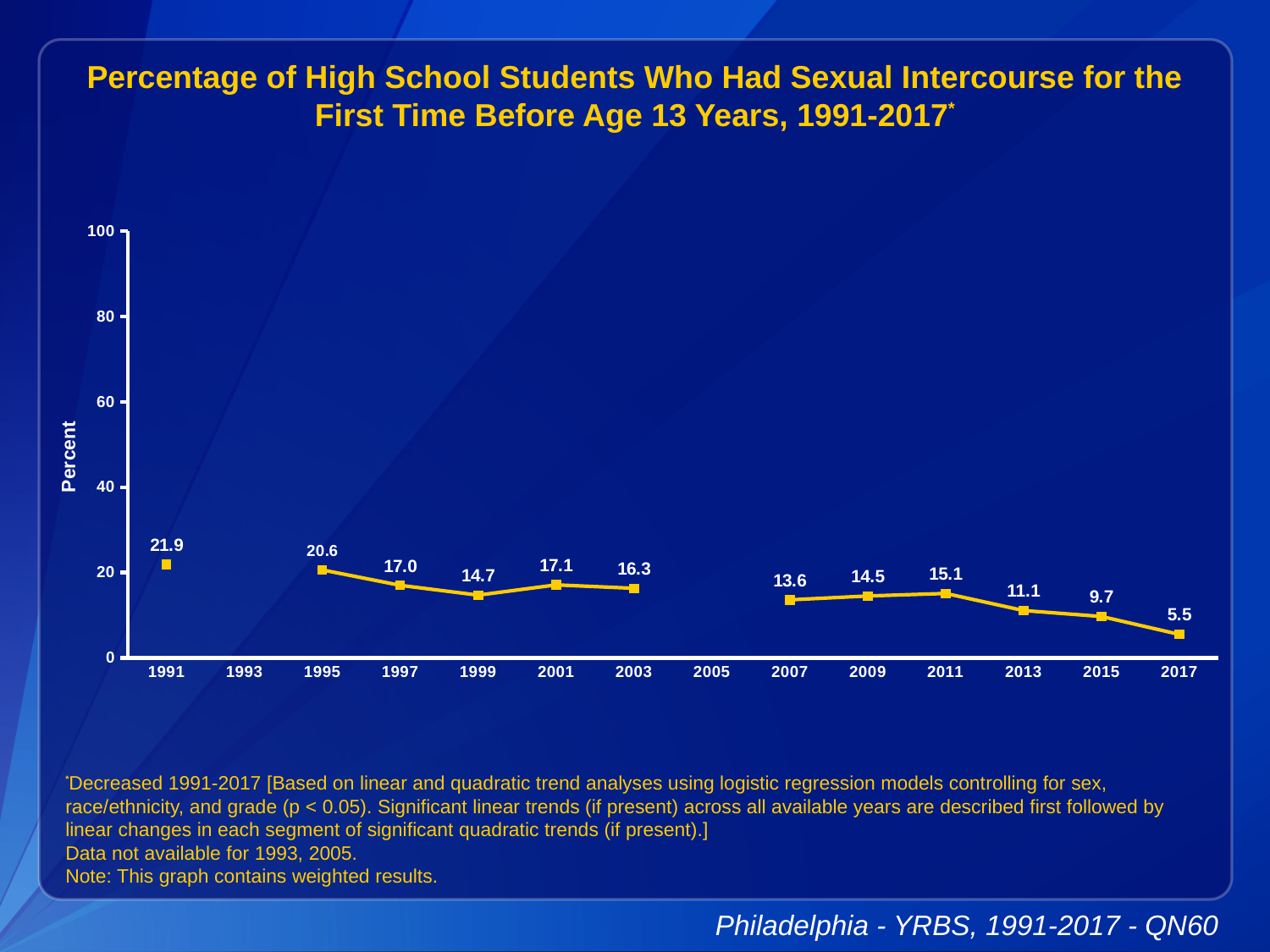
What is the value for 1991? 21.9 What kind of chart is shown on the slide? line chart How many years have data points plotted on the chart? 12 What is the value for 2017? 5.5 What is the value for 2009? 14.5 Do the values generally rise or fall from 1991 to 2017? fall Which is larger, the value for 2003 or the value for 2007? 2003 Is the value for 1995 greater or less than 20? greater Which year has the highest value? 1991 Which year has the lowest value? 2017 What is the difference between the values for 1991 and 2017? 16.4 What is the label on the y axis? Percent